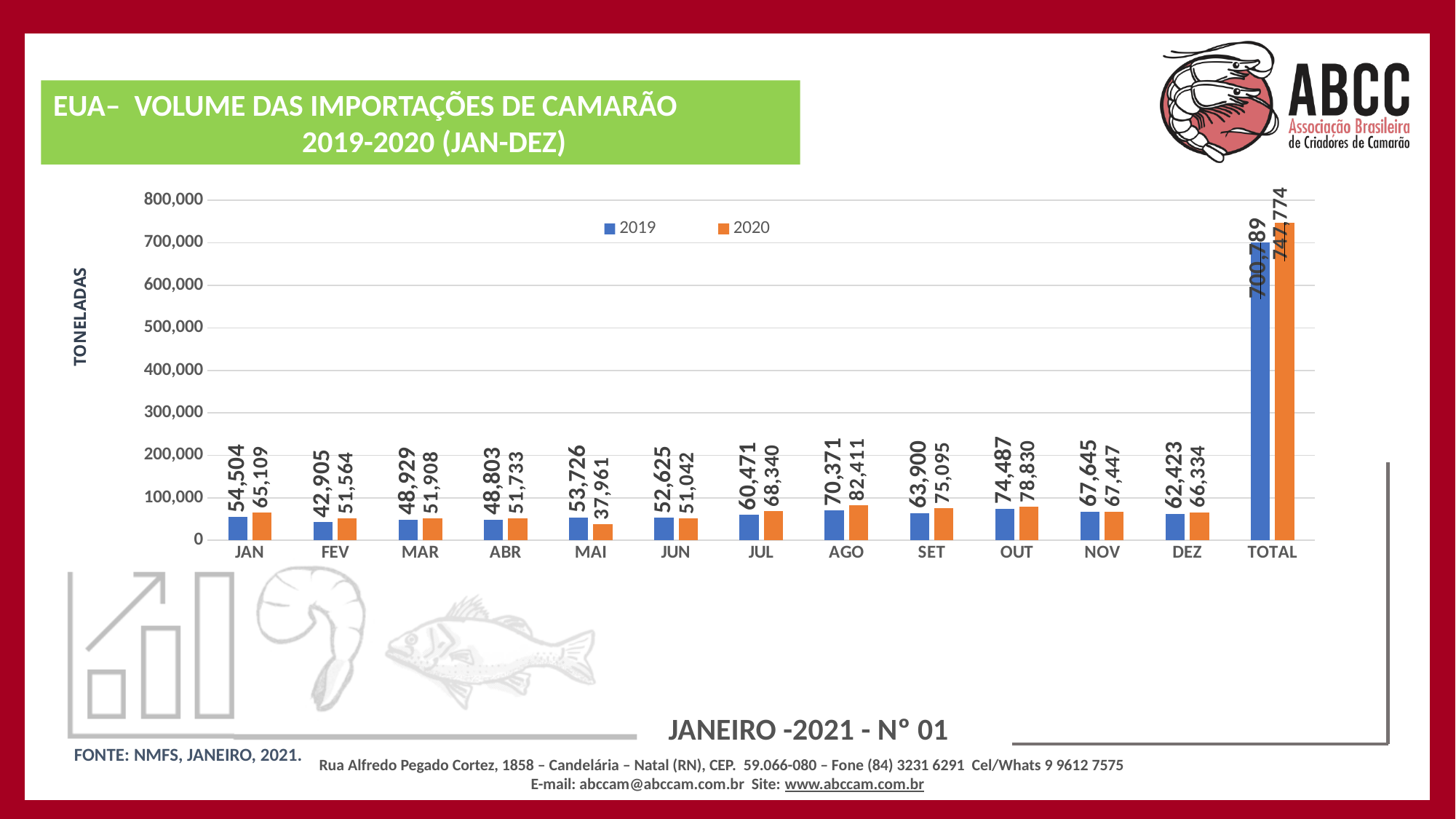
For MAI, which series has the larger value, 2019 or 2020? 2019 How many categories are shown on the x axis? 13 Among the monthly categories (excluding TOTAL), which month has the highest 2019 value? OUT For JAN, which series has the larger value, 2019 or 2020? 2020 What kind of chart is shown on the slide? bar chart Among the monthly categories (excluding TOTAL), which month has the lowest 2020 value? MAI What is the label on the vertical axis of the chart? TONELADAS What is the 2020 value for AGO? 82,411 Is the 2020 TOTAL value greater or less than 700,000? greater What is the 2019 value for MAI? 53,726 How many series does the legend list? 2 What is the difference between the 2020 TOTAL and the 2019 TOTAL? 46,985